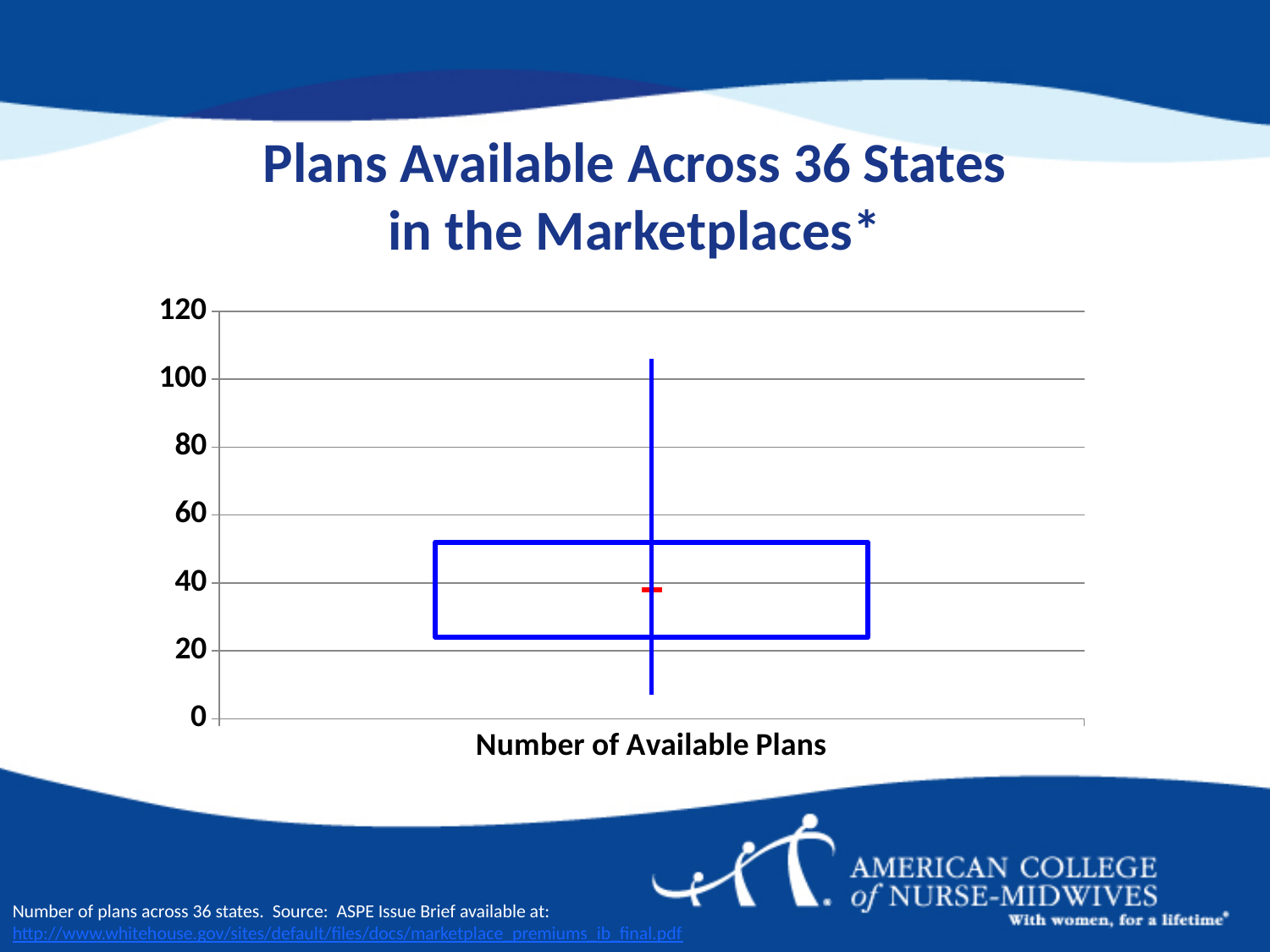
Is the median marker for Number of Available Plans greater or less than 60? less How many categories are plotted on the x axis? 1 What is the label on the x axis of the chart? Number of Available Plans Is the top of the box for Number of Available Plans greater or less than 40? greater What kind of chart is shown on the slide? Box-and-whisker plot Is the bottom of the lower whisker for Number of Available Plans greater or less than 20? less What is the highest value shown on the y axis? 120 What is the title of the chart? Plans Available Across 36 States in the Marketplaces*